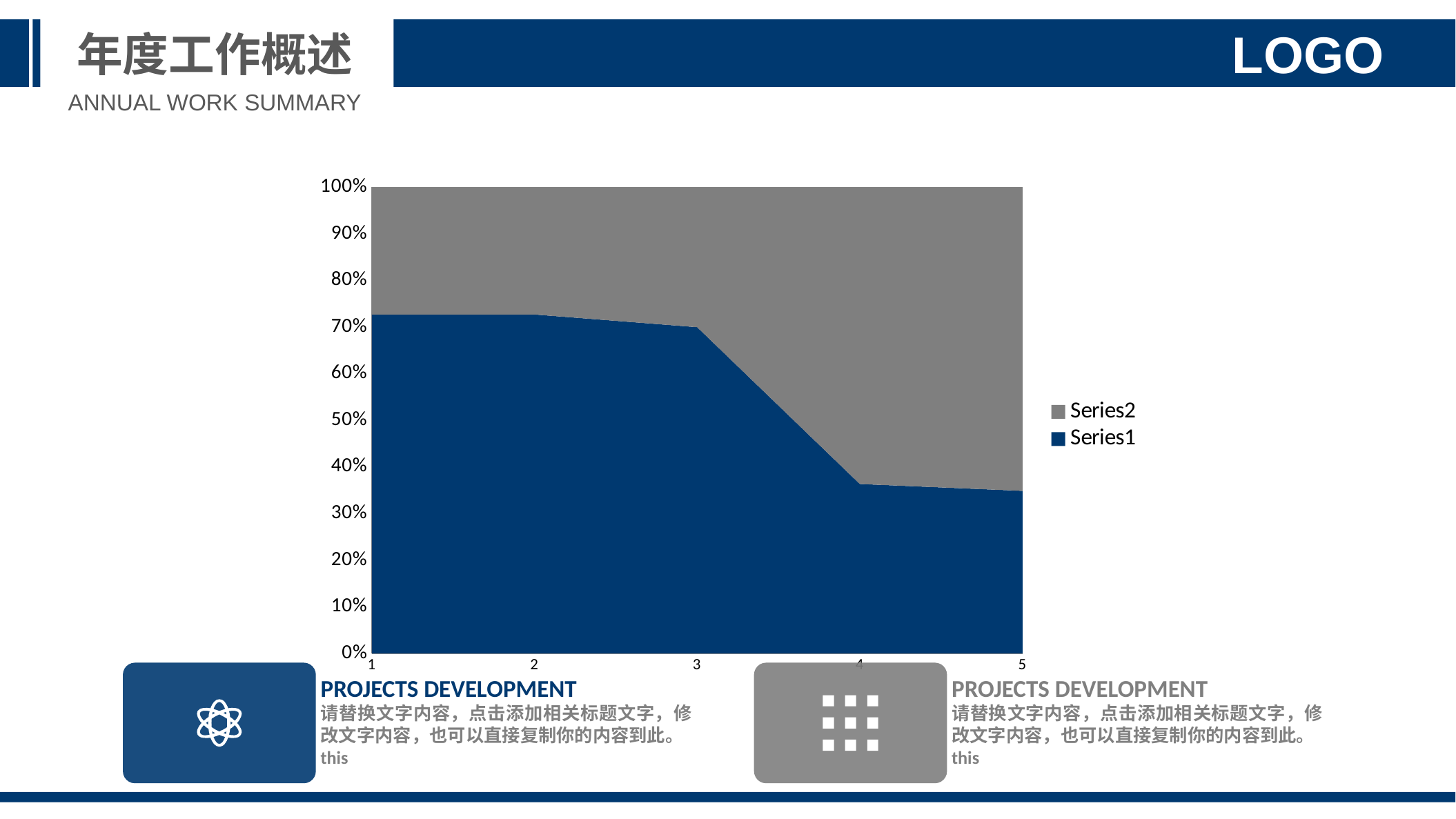
Is the value for Series1 at category 3 greater or less than 60%? greater Is the value for Series1 at category 4 greater or less than 40%? less Which is larger for Series1: the value at category 1 or the value at category 5? Category 1 Is the value for Series1 at category 1 greater or less than 60%? greater What are the two entries listed in the chart legend? Series2 and Series1 What colour represents Series1 in the chart? Dark blue What kind of chart is shown on the slide? Area chart Does the share of Series1 rise or fall from category 1 to category 5? Fall Which is larger for Series1: the value at category 3 or the value at category 4? Category 3 How many series does the chart legend list? 2 How many points are plotted along the x axis of the chart? 5